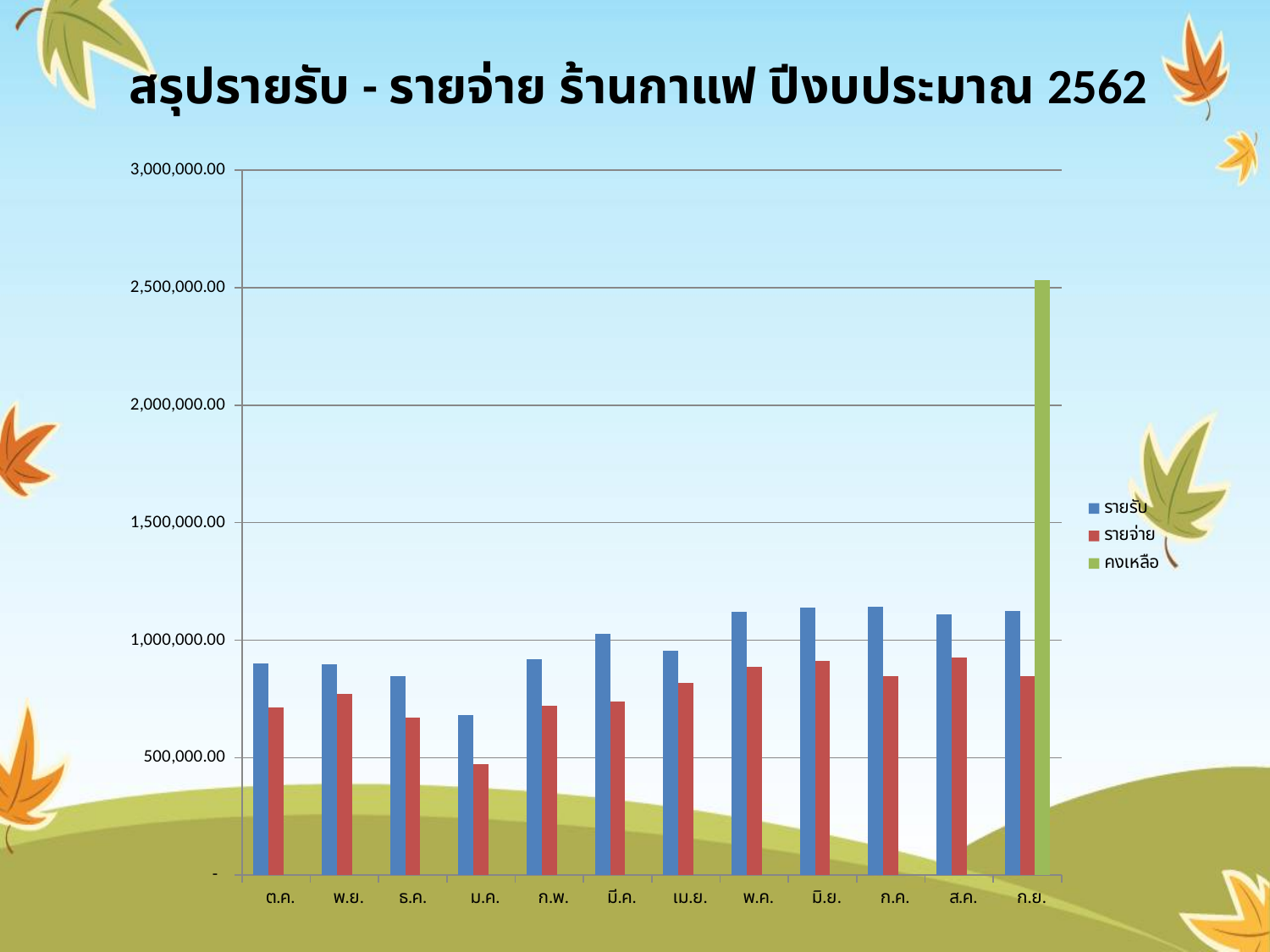
Do the รายรับ values rise or fall from ม.ค. to พ.ค.? rise Is the รายรับ value for ม.ค. greater or less than 1,000,000.00? less What is the title of the chart on the slide? สรุปรายรับ - รายจ่าย ร้านกาแฟ ปีงบประมาณ 2562 How many months are shown along the x axis of the chart? 12 What are the three series listed in the chart's legend? รายรับ, รายจ่าย, คงเหลือ How many series does the chart's legend list? 3 Is the รายจ่าย value for ม.ค. greater or less than 500,000.00? less In which month is the รายรับ value lowest? ม.ค. What kind of chart is shown on the slide? bar chart In which month is the รายจ่าย value lowest? ม.ค. Which is larger in ต.ค., the รายรับ value or the รายจ่าย value? รายรับ Is the คงเหลือ value for ก.ย. greater or less than 2,000,000.00? greater